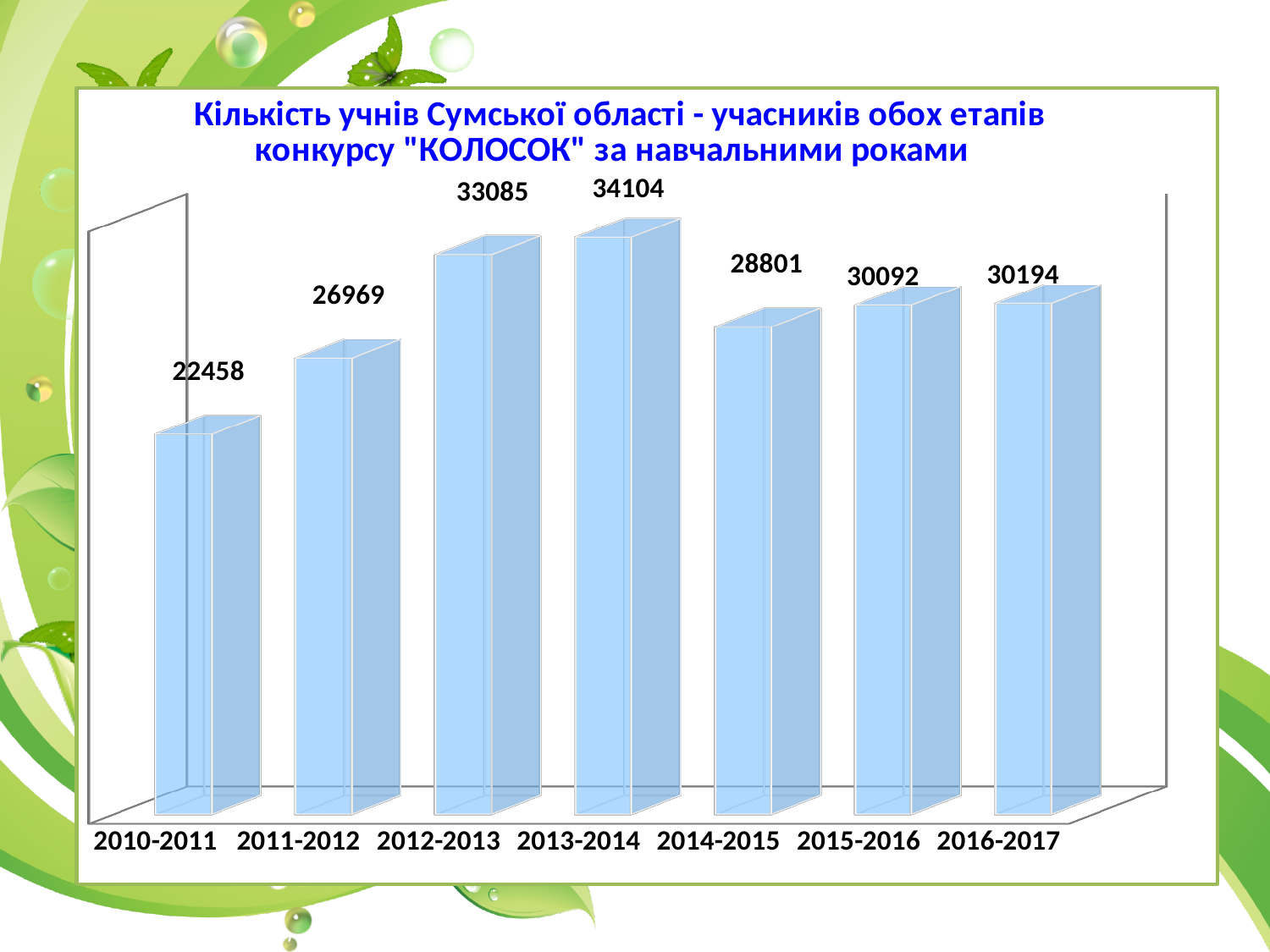
Do the values rise or fall from 2010-2011 to 2013-2014? rise Which school year has the highest value? 2013-2014 What kind of chart is this? bar chart What is the value for 2013-2014? 34104 What is the title of the chart? Кількість учнів Сумської області - учасників обох етапів конкурсу "КОЛОСОК" за навчальними роками What is the difference between the values for 2013-2014 and 2012-2013? 1019 What is the value for 2010-2011? 22458 Which is larger, the value for 2012-2013 or the value for 2014-2015? 2012-2013 Which school year has the lowest value? 2010-2011 How many school years are shown on the chart? 7 What is the difference between the values for 2011-2012 and 2010-2011? 4511 What is the value for 2016-2017? 30194